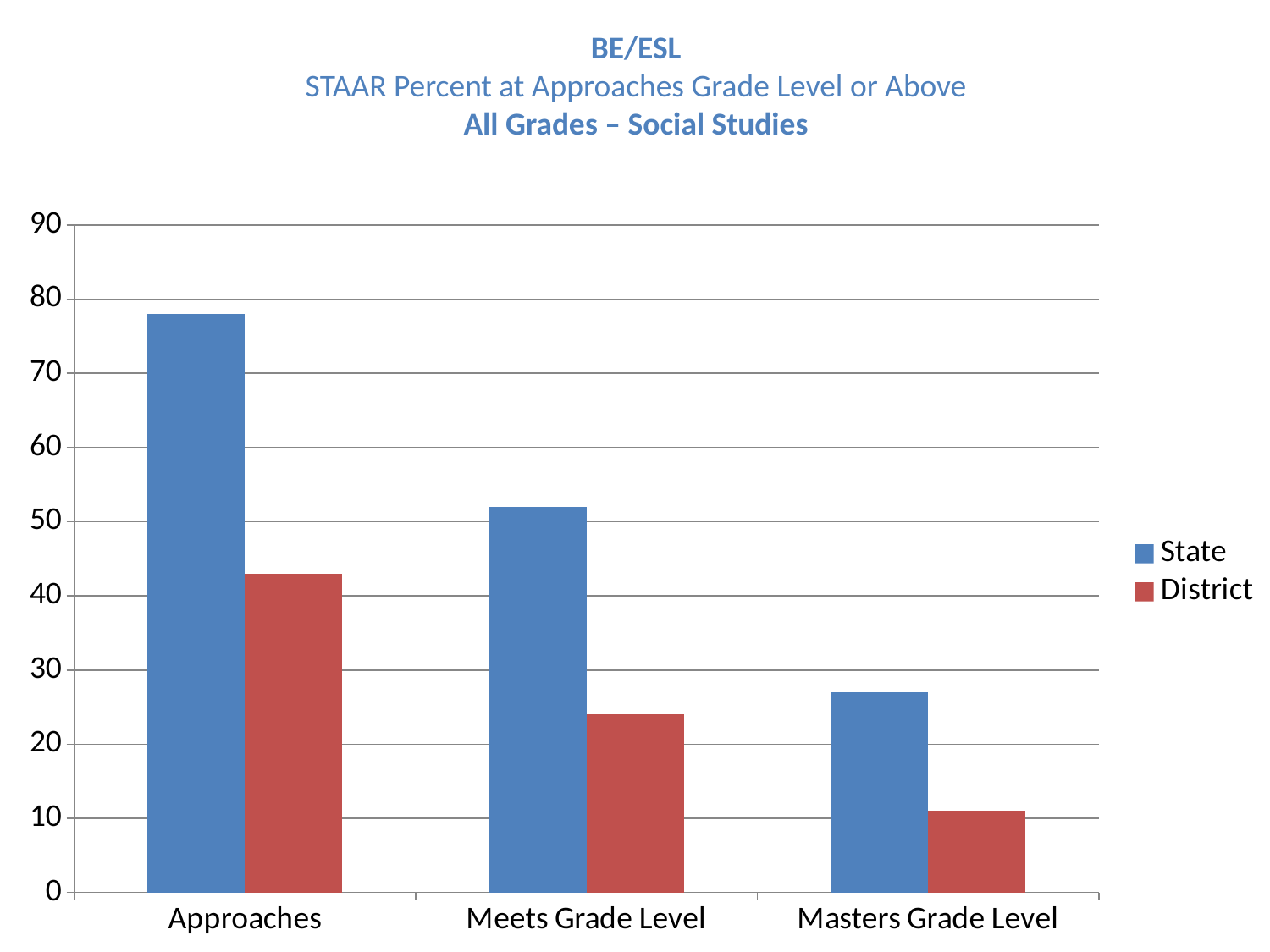
Which colour represents the District series in the legend? red For Meets Grade Level, which is larger, the State value or the District value? State Which category has the highest State value? Approaches How many categories are shown on the x axis? 3 Is the District value for Masters Grade Level greater or less than 20? less Which category has the lowest District value? Masters Grade Level Is the State value for Masters Grade Level greater or less than 20? greater Do the District values rise or fall from Approaches to Masters Grade Level? fall Is the District value for Meets Grade Level greater or less than 30? less What kind of chart is shown on the slide? bar chart How many series does the legend list? 2